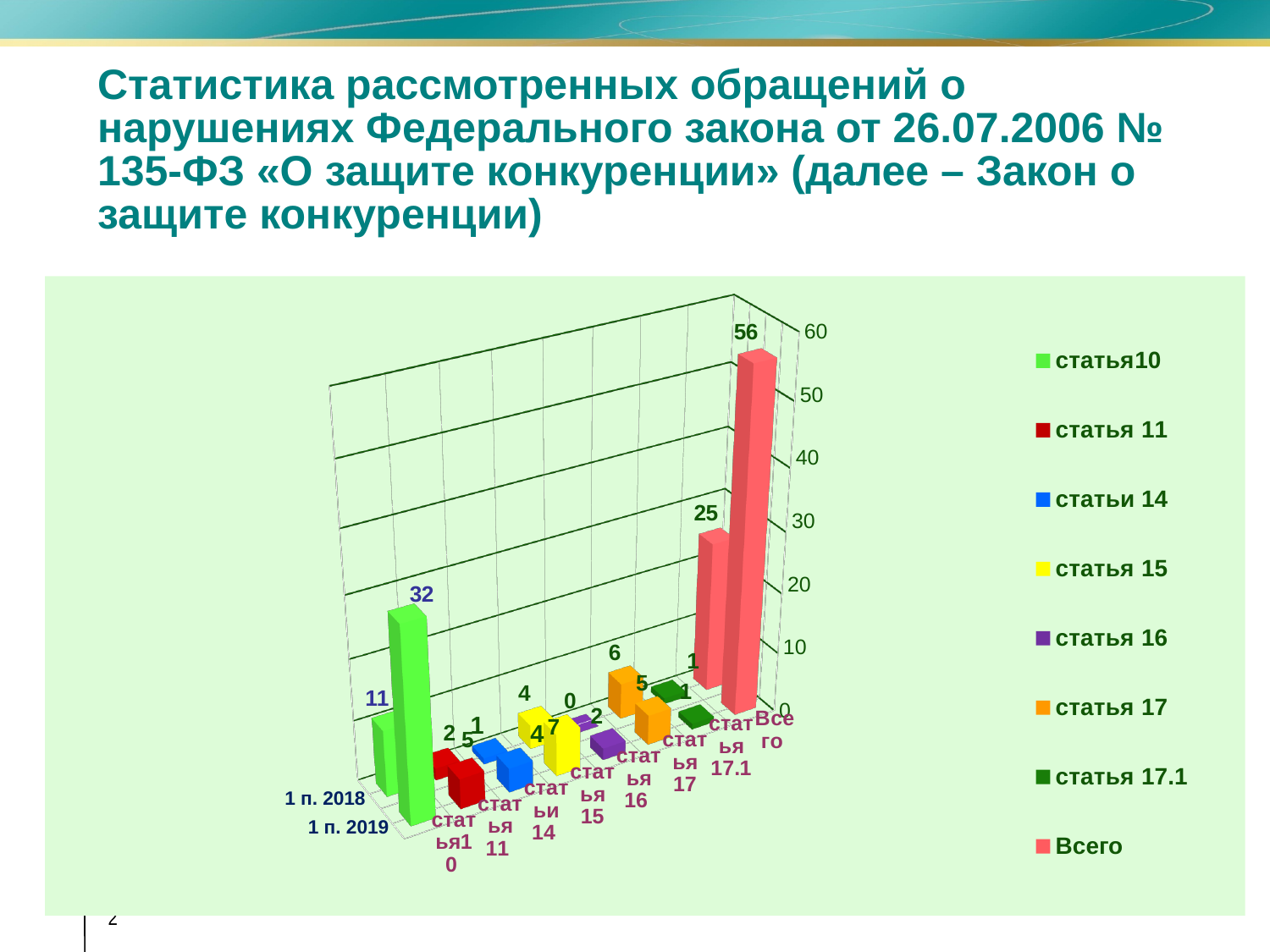
How many series does the legend list? 8 What is the value for Всего in 1 п. 2018? 25 Which is larger: статья 17 in 1 п. 2018 or статья 17 in 1 п. 2019? 1 п. 2018 What is the difference between статья10 in 1 п. 2019 and 1 п. 2018? 21 What is the value for статья10 in 1 п. 2018? 11 What is the value for статья 17 in 1 п. 2018? 6 By how much did Всего increase from 1 п. 2018 to 1 п. 2019? 31 Excluding Всего, which article has the highest value in 1 п. 2019? статья10 What is the value for статья10 in 1 п. 2019? 32 What is the value for статья 16 in 1 п. 2018? 0 What kind of chart is shown on the slide? bar chart What is the value for Всего in 1 п. 2019? 56